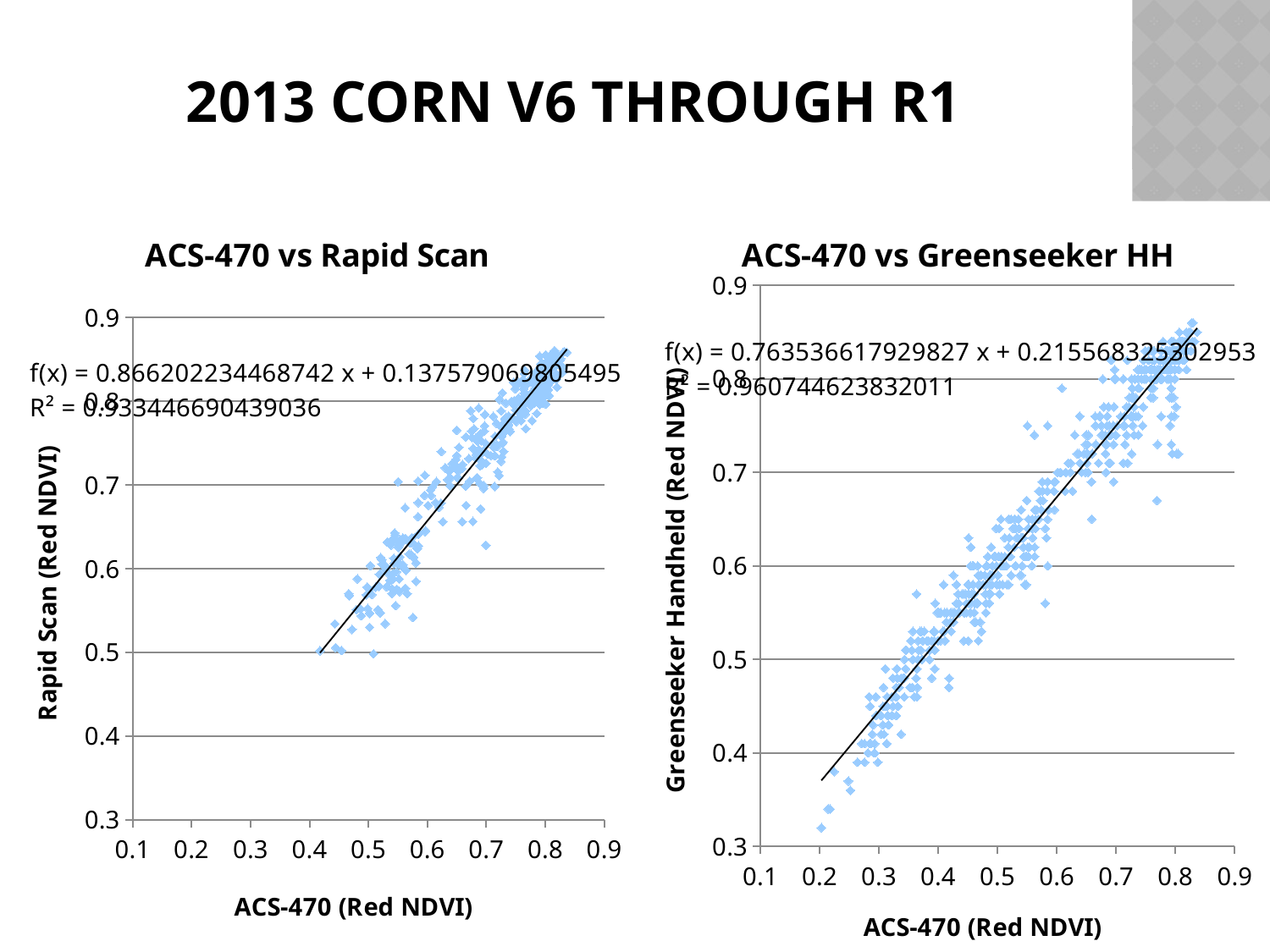
What is the y-axis label of the 'ACS-470 vs Greenseeker HH' chart? Greenseeker Handheld (Red NDVI) In the 'ACS-470 vs Greenseeker HH' chart, do the Greenseeker Handheld values rise or fall as ACS-470 increases along the x axis? rise Which chart has the larger trendline slope, 'ACS-470 vs Rapid Scan' or 'ACS-470 vs Greenseeker HH'? ACS-470 vs Rapid Scan What kind of chart is the 'ACS-470 vs Rapid Scan' chart? scatter chart What kind of chart is the 'ACS-470 vs Greenseeker HH' chart? scatter chart Which chart has the higher R² value, 'ACS-470 vs Rapid Scan' or 'ACS-470 vs Greenseeker HH'? ACS-470 vs Greenseeker HH What is the trendline equation shown on the 'ACS-470 vs Greenseeker HH' chart? f(x) = 0.763536617929827 x + 0.215568325302953 What is the trendline equation shown on the 'ACS-470 vs Rapid Scan' chart? f(x) = 0.866202234468742 x + 0.137579069805495 What is the R² value shown on the 'ACS-470 vs Greenseeker HH' chart? 0.960744623832011 In the 'ACS-470 vs Rapid Scan' chart, do the Rapid Scan values rise or fall as ACS-470 increases along the x axis? rise What is the x-axis label of the 'ACS-470 vs Rapid Scan' chart? ACS-470 (Red NDVI) What is the R² value shown on the 'ACS-470 vs Rapid Scan' chart? 0.933446690439036